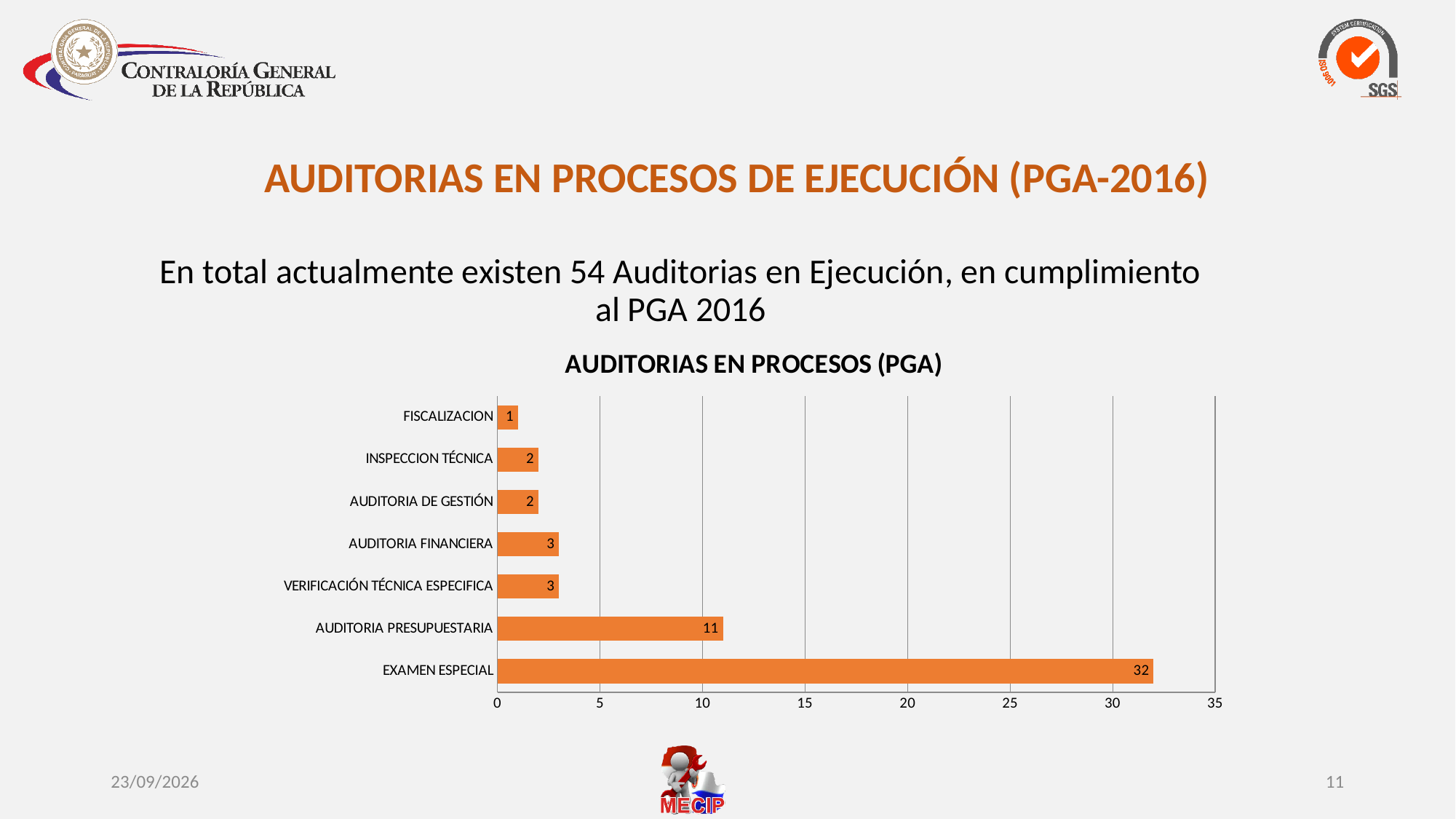
Which is larger, the value for AUDITORIA PRESUPUESTARIA or the value for AUDITORIA DE GESTIÓN? AUDITORIA PRESUPUESTARIA Which category has the lowest value? FISCALIZACION What is the value for AUDITORIA PRESUPUESTARIA? 11 Which category has the highest value? EXAMEN ESPECIAL What is the value for EXAMEN ESPECIAL? 32 What is the title of the chart? AUDITORIAS EN PROCESOS (PGA) What is the value for AUDITORIA FINANCIERA? 3 What kind of chart is shown on the slide? bar chart What is the difference between the values for EXAMEN ESPECIAL and AUDITORIA PRESUPUESTARIA? 21 How many categories are shown in the chart? 7 What is the value for FISCALIZACION? 1 Is the value for EXAMEN ESPECIAL greater or less than 30? greater